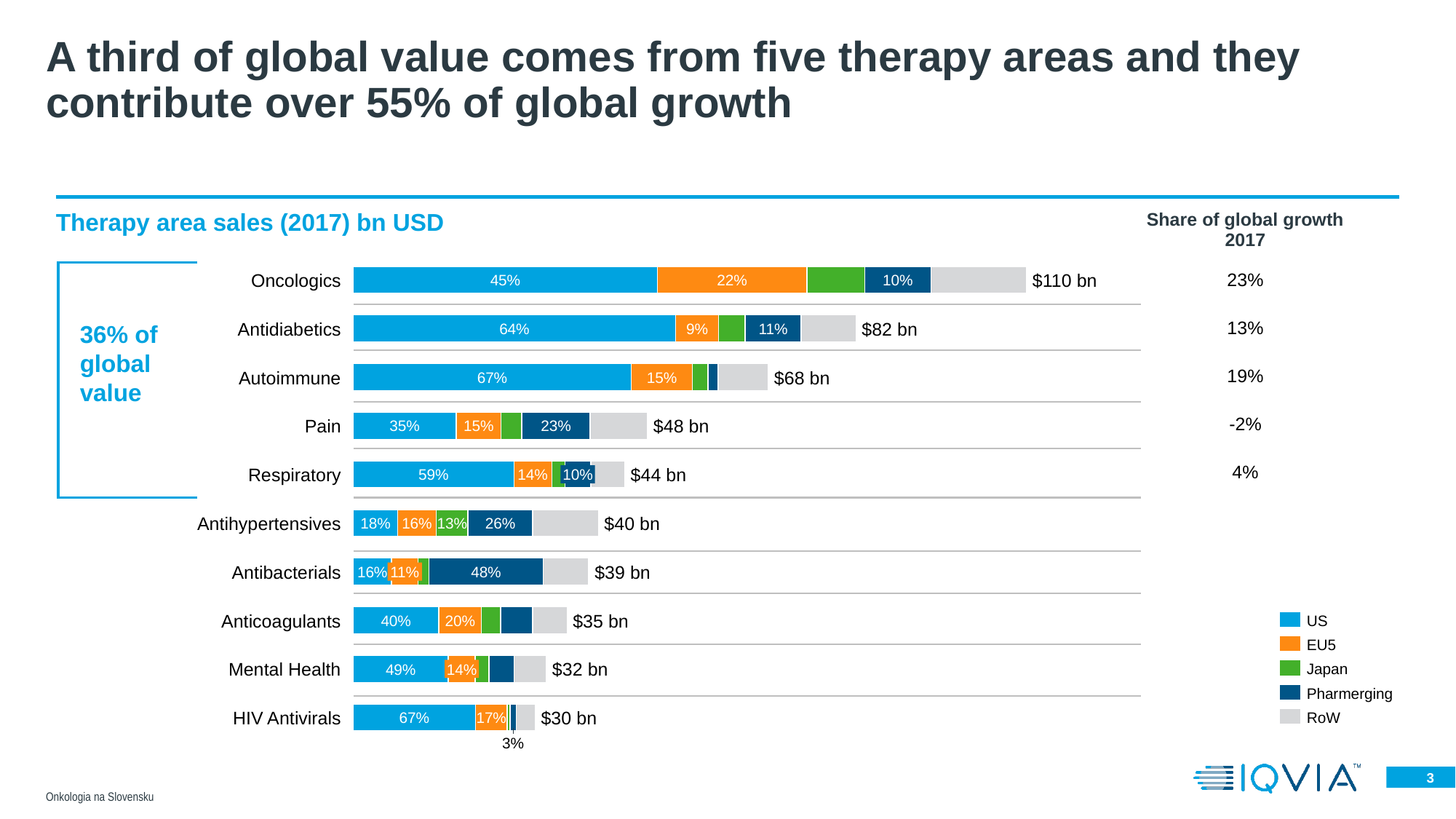
Which has larger total sales, Pain or Respiratory? Pain How many series does the legend list? 5 What is the share of global growth 2017 for Autoimmune? 19% How many therapy areas are shown in the chart? 10 What percentage of Antibacterials sales comes from Pharmerging markets? 48% What kind of chart is shown on the slide? Stacked bar chart What is the share of global growth 2017 for Pain? -2% Which therapy area has the highest total sales in 2017? Oncologics What percentage of Antidiabetics sales comes from the US? 64% What is the difference in total sales between Oncologics and Antidiabetics? $28 bn What are the total 2017 sales for Oncologics? $110 bn Which therapy area has the lowest total sales in 2017? HIV Antivirals